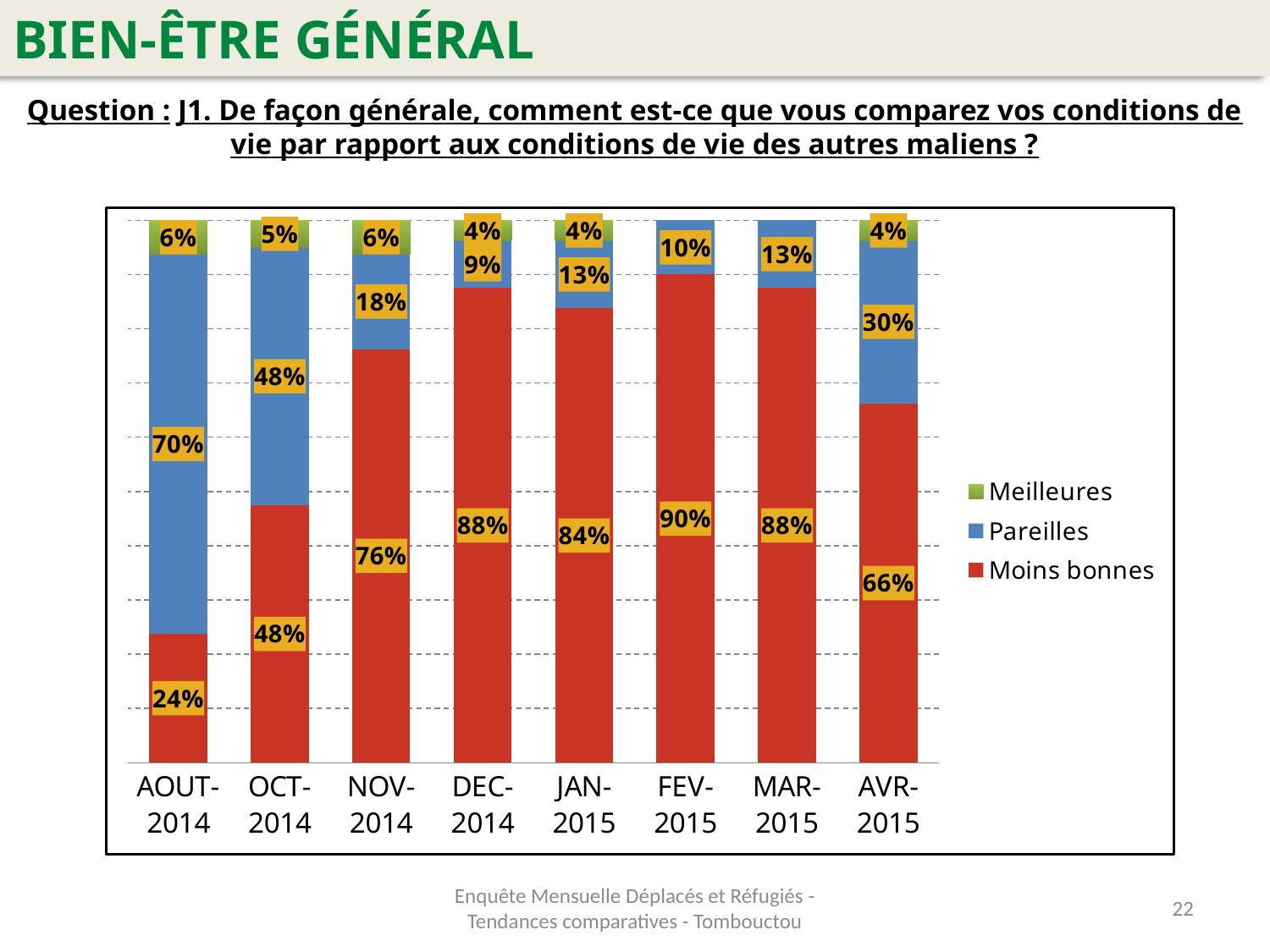
What is the difference between the "Pareilles" value in AOUT-2014 and in AVR-2015? 40 percentage points Which month has a larger "Moins bonnes" value, DEC-2014 or JAN-2015? DEC-2014 In which month is the "Moins bonnes" share the highest? FEV-2015 Does the "Moins bonnes" share rise or fall from AOUT-2014 to FEV-2015? Rises In which month is the "Moins bonnes" share the lowest? AOUT-2014 In which month is the "Pareilles" share the highest? AOUT-2014 What is the value for "Meilleures" in OCT-2014? 5% What percentage of respondents answered "Moins bonnes" in AOUT-2014? 24% What kind of chart is shown on the slide? Stacked bar chart How many series does the legend list? 3 How many months are shown on the x axis of the chart? 8 What is the value for "Pareilles" in NOV-2014? 18%